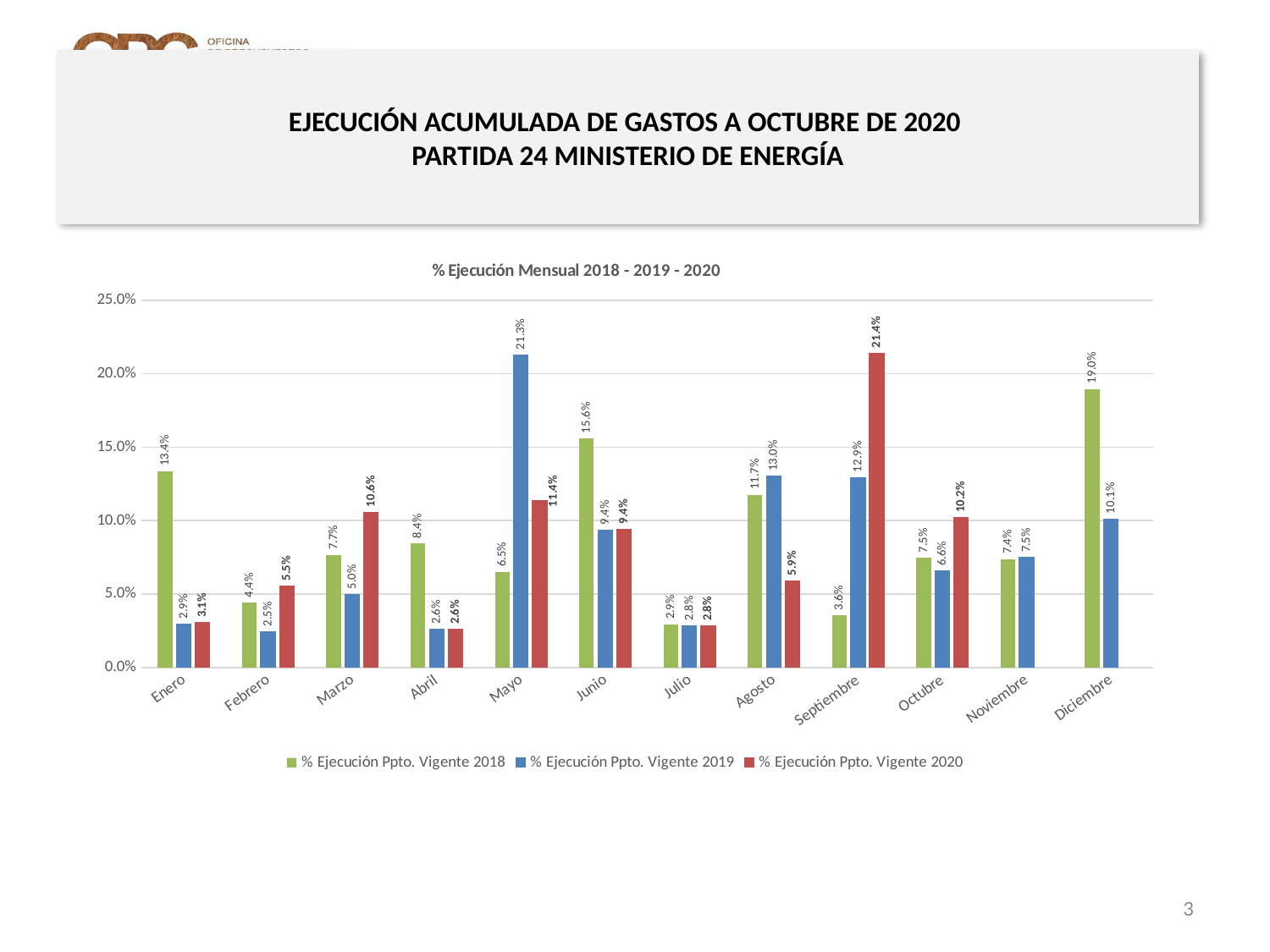
Which month has the highest value for % Ejecución Ppto. Vigente 2018? Diciembre In Agosto, which series has the larger value: % Ejecución Ppto. Vigente 2018 or % Ejecución Ppto. Vigente 2019? % Ejecución Ppto. Vigente 2019 What is the difference between the 2020 and 2018 values in Marzo? 2.9 percentage points How many series does the legend list? 3 Which month has the lowest value for % Ejecución Ppto. Vigente 2019? Febrero Which month has the highest value for % Ejecución Ppto. Vigente 2020? Septiembre What kind of chart is shown on the slide? Bar chart What is the title of the chart? % Ejecución Mensual 2018 - 2019 - 2020 How many months are shown on the x axis? 12 What is the value for % Ejecución Ppto. Vigente 2019 in Mayo? 21.3% What is the value for % Ejecución Ppto. Vigente 2020 in Octubre? 10.2% What is the value for % Ejecución Ppto. Vigente 2020 in Septiembre? 21.4%